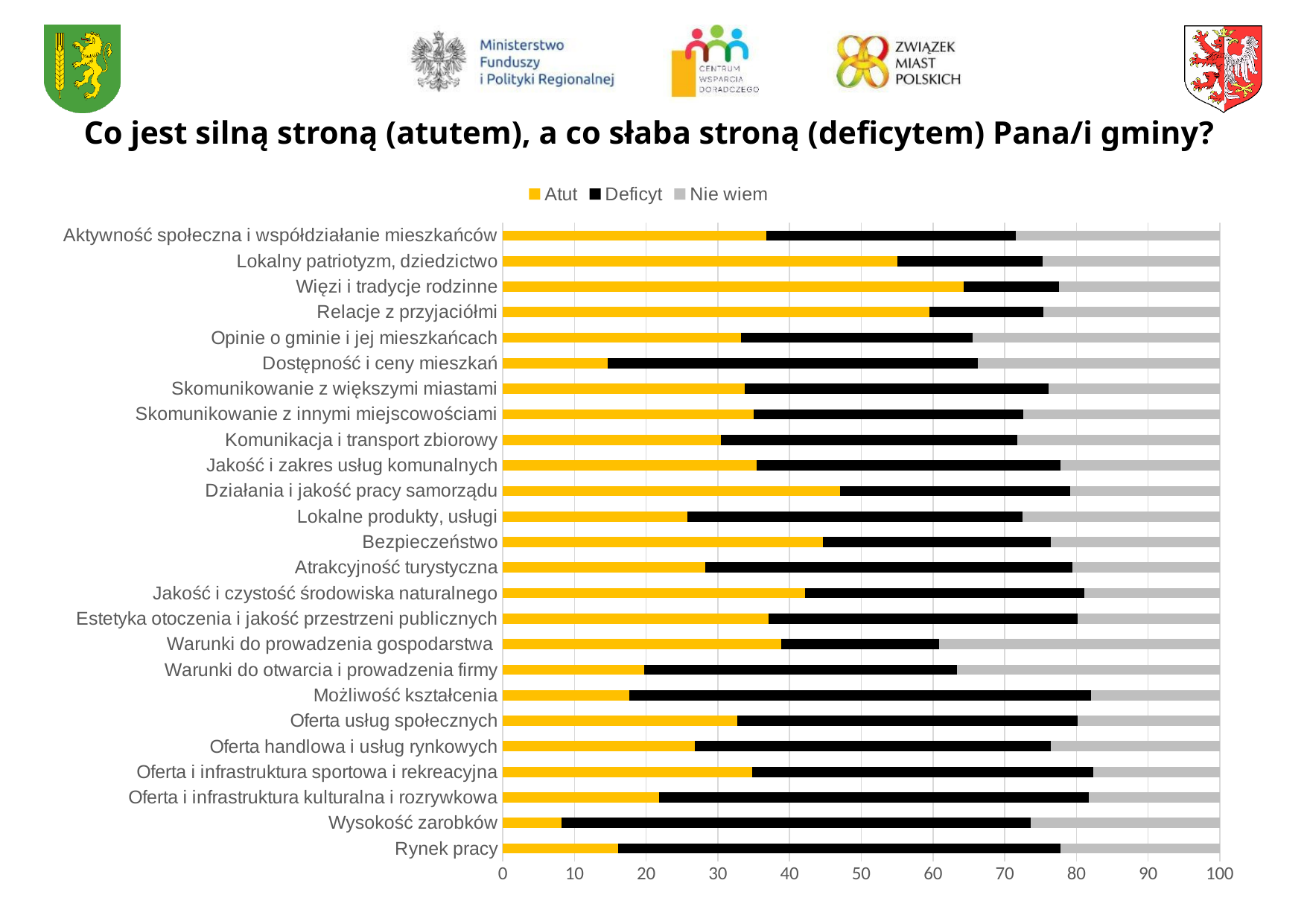
What colour represents the Deficyt series? Black Is the Atut value for Wysokość zarobków greater or less than 10? less Which category has the lowest Atut value? Wysokość zarobków What kind of chart is shown on the slide? Stacked bar chart How many series does the legend list? 3 Which has the larger Atut value: Lokalny patriotyzm, dziedzictwo or Aktywność społeczna i współdziałanie mieszkańców? Lokalny patriotyzm, dziedzictwo Is the Atut value for Dostępność i ceny mieszkań greater or less than 20? less Which category has the highest Atut value? Więzi i tradycje rodzinne What are the three series named in the legend? Atut, Deficyt, Nie wiem Which has the larger Atut value: Bezpieczeństwo or Atrakcyjność turystyczna? Bezpieczeństwo How many categories are plotted on the chart? 25 Is the Atut value for Więzi i tradycje rodzinne greater or less than 60? greater